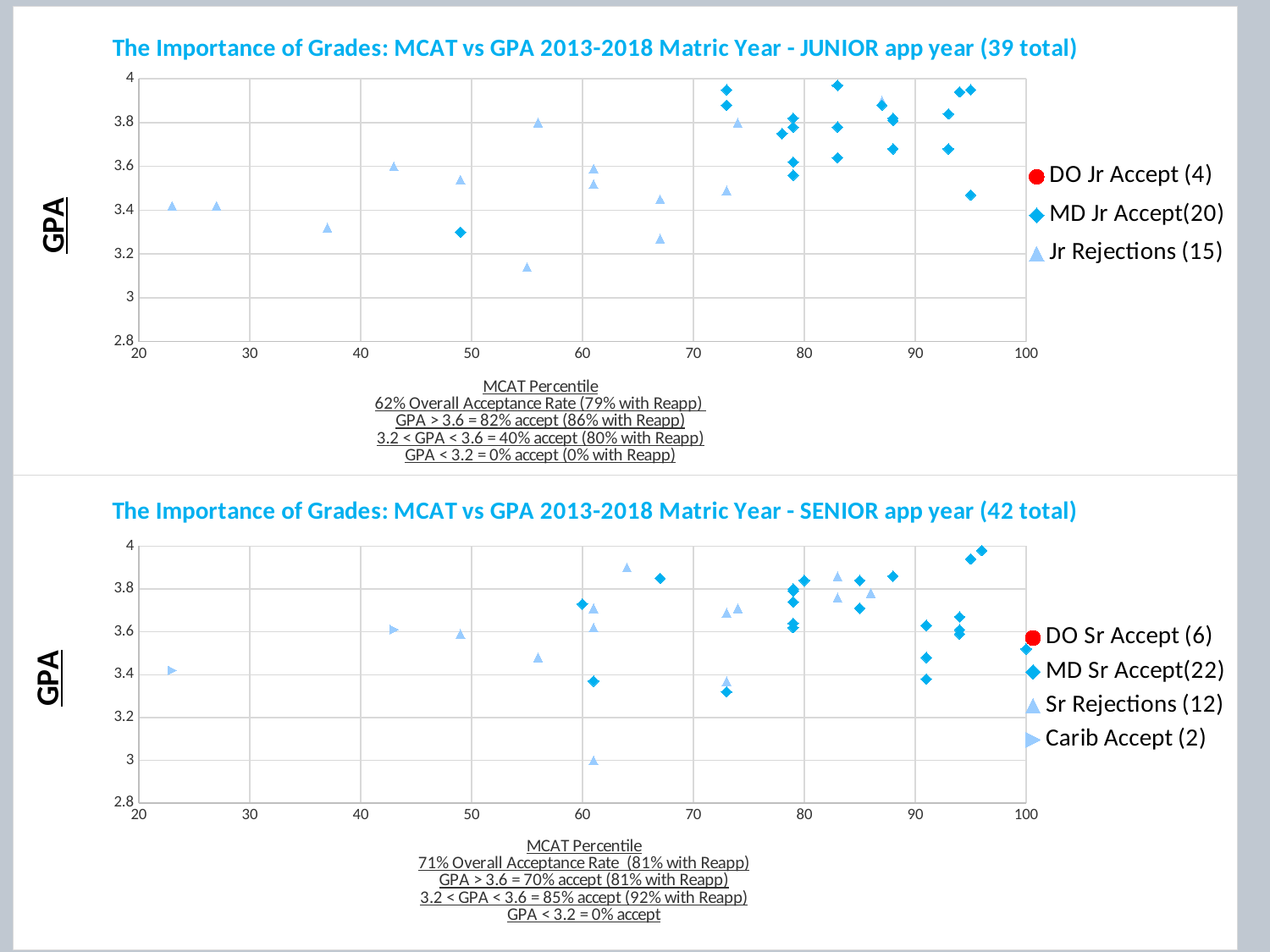
What is the label of the vertical axis on both charts? GPA In the bottom chart (SENIOR app year), which series has more applicants according to the legend: MD Sr Accept or DO Sr Accept? MD Sr Accept How many series does the legend of the top chart (JUNIOR app year) list? 3 In the bottom chart (SENIOR app year), how many applicants are in the Sr Rejections series according to the legend? 12 How many series does the legend of the bottom chart (SENIOR app year) list? 4 According to the chart titles, how many total applicants are in the JUNIOR app year chart? 39 In the top chart (JUNIOR app year), is the GPA of the Jr Rejections point at the lowest MCAT percentile (around 23) greater or less than 3.2? greater What is the difference between the number of MD Sr Accept applicants (bottom chart legend) and MD Jr Accept applicants (top chart legend)? 2 In the top chart (JUNIOR app year), how many applicants are in the MD Jr Accept series according to the legend? 20 What kind of chart is the top chart (JUNIOR app year)? scatter chart According to the chart titles, how many total applicants are in the SENIOR app year chart? 42 In the bottom chart (SENIOR app year), is the GPA of the lowest Sr Rejections point (at MCAT percentile around 61) greater or less than 3.2? less